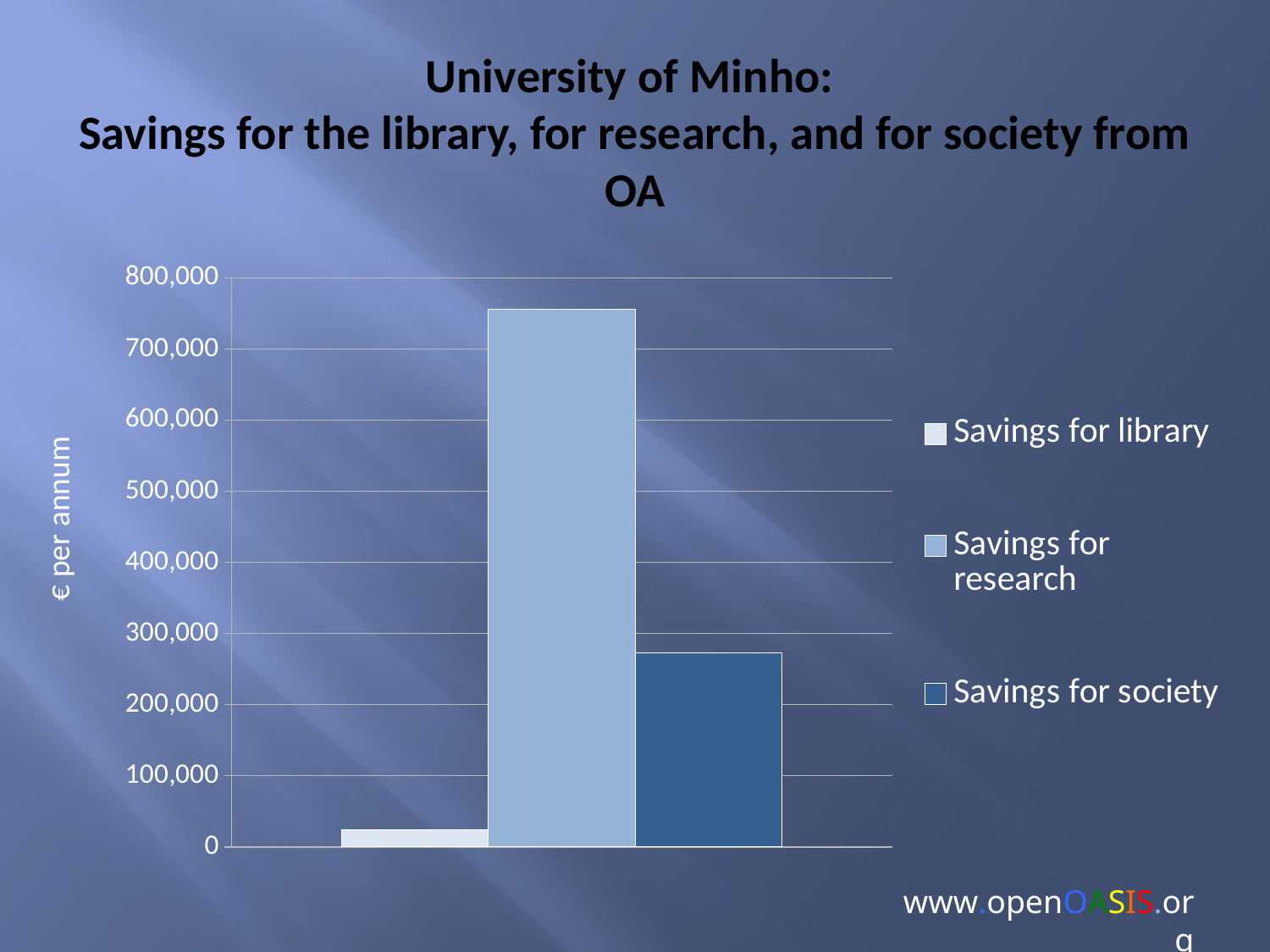
How many series does the legend list? 3 Which series has the lowest value? Savings for library Is the value for Savings for society greater or less than 200,000? greater Is the value for Savings for library greater or less than 100,000? less Which series has the highest value? Savings for research Is the value for Savings for society greater or less than 300,000? less What kind of chart is shown on the slide? bar chart Which is larger, Savings for research or Savings for society? Savings for research What is the highest value shown on the vertical axis? 800,000 Which is larger, Savings for society or Savings for library? Savings for society What is the label on the vertical axis of the chart? € per annum